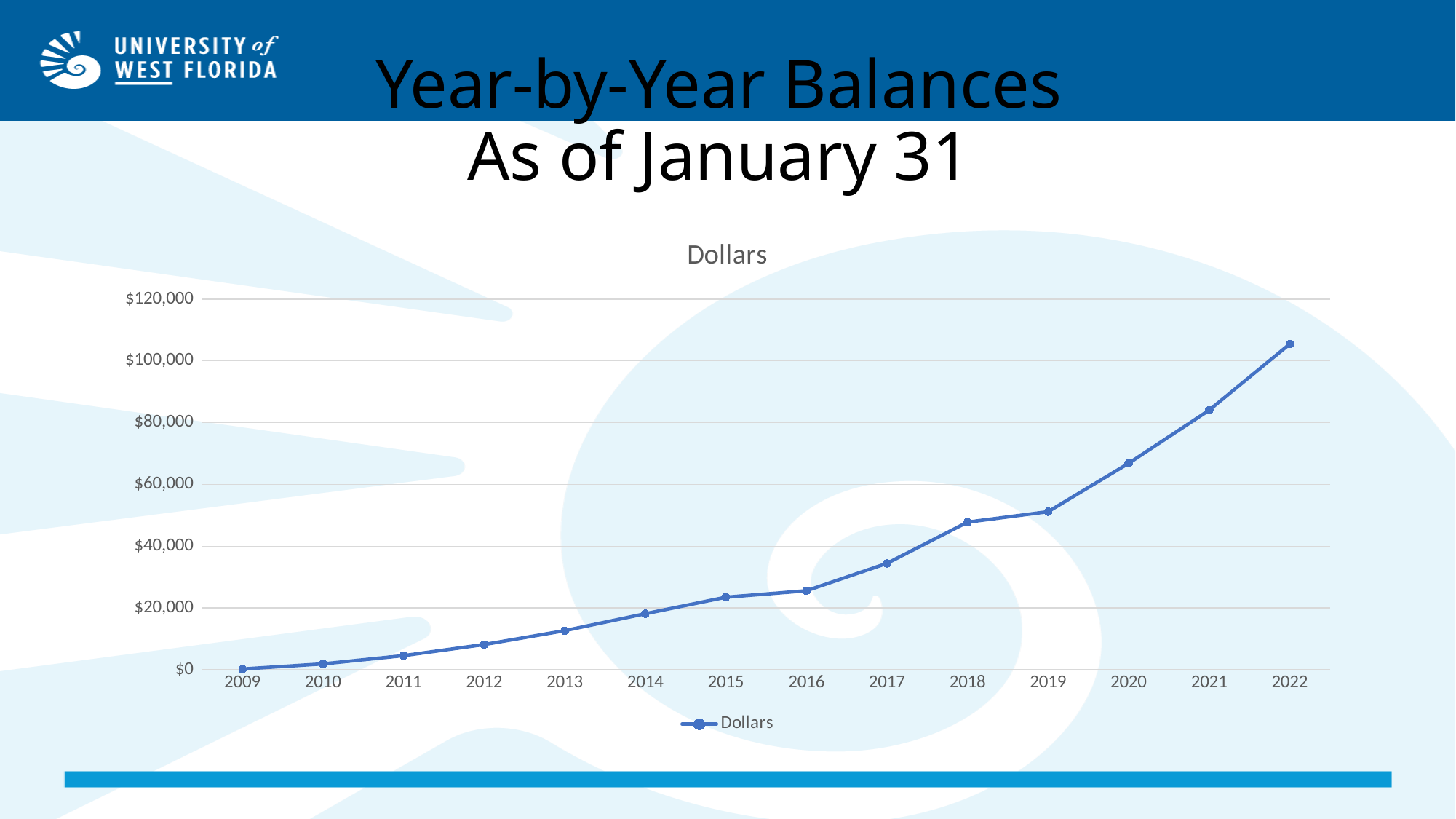
Do the balances rise or fall from 2009 to 2022? rise What is the title of the chart? Dollars How many series does the legend list? 1 Which year has the lowest balance? 2009 Is the value for 2019 greater or less than $40,000? greater Which is larger, the balance in 2018 or the balance in 2021? 2021 Is the value for 2017 greater or less than $40,000? less Is the value for 2022 greater or less than $100,000? greater What kind of chart is shown on the slide? line chart Which year has the highest balance? 2022 How many years are plotted on the x axis? 14